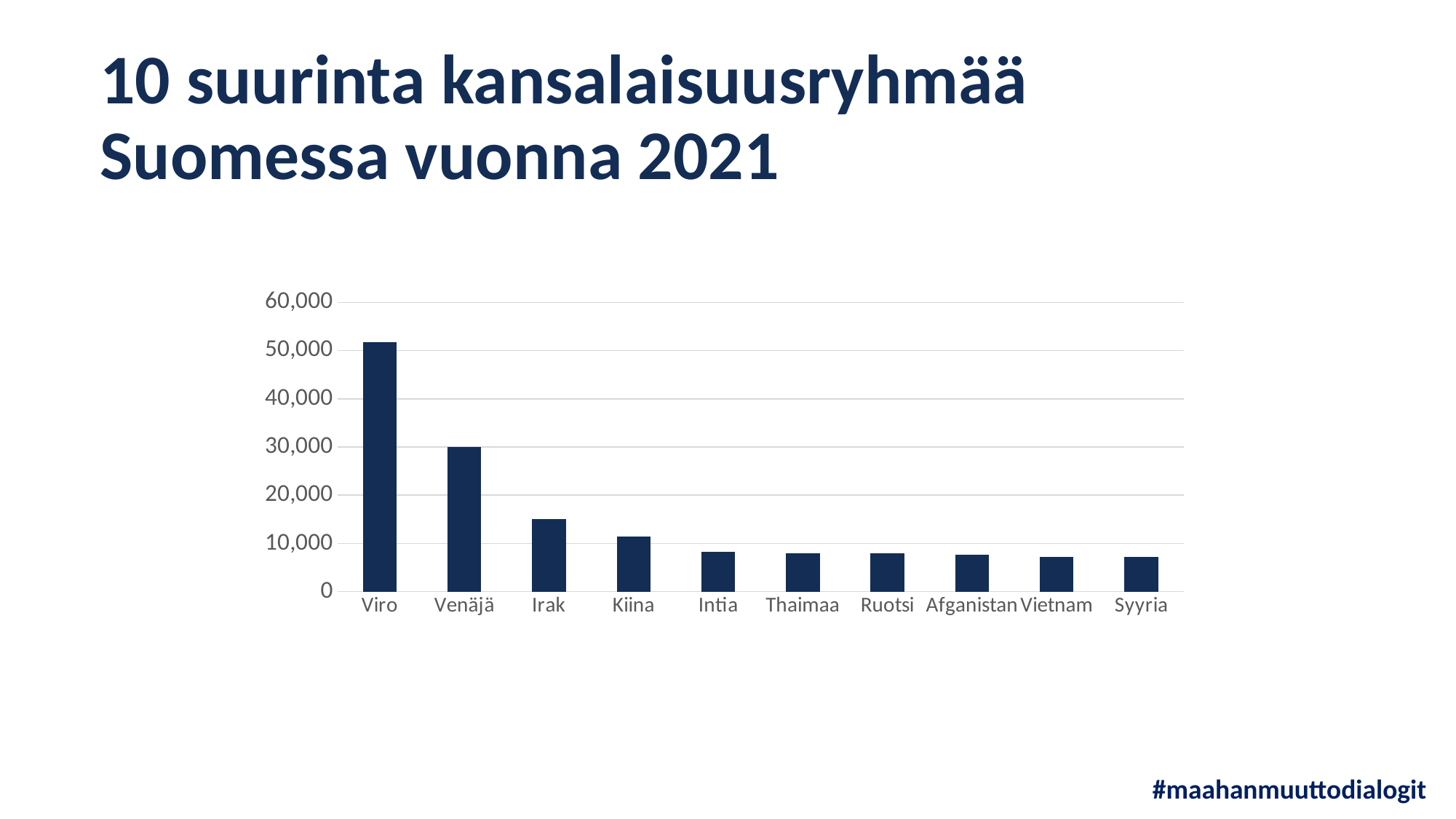
What is the title of the slide? 10 suurinta kansalaisuusryhmää Suomessa vuonna 2021 Is the value for Irak greater or less than 20,000? less What kind of chart is shown on the slide? bar chart How many countries are shown on the chart? 10 Which is larger, the value for Viro or the value for Venäjä? Viro Is the value for Kiina greater or less than 10,000? greater Is the value for Viro greater or less than 50,000? greater Do the values rise or fall from left to right along the x axis? fall Which country has the highest value on the chart? Viro Which is larger, the value for Irak or the value for Kiina? Irak